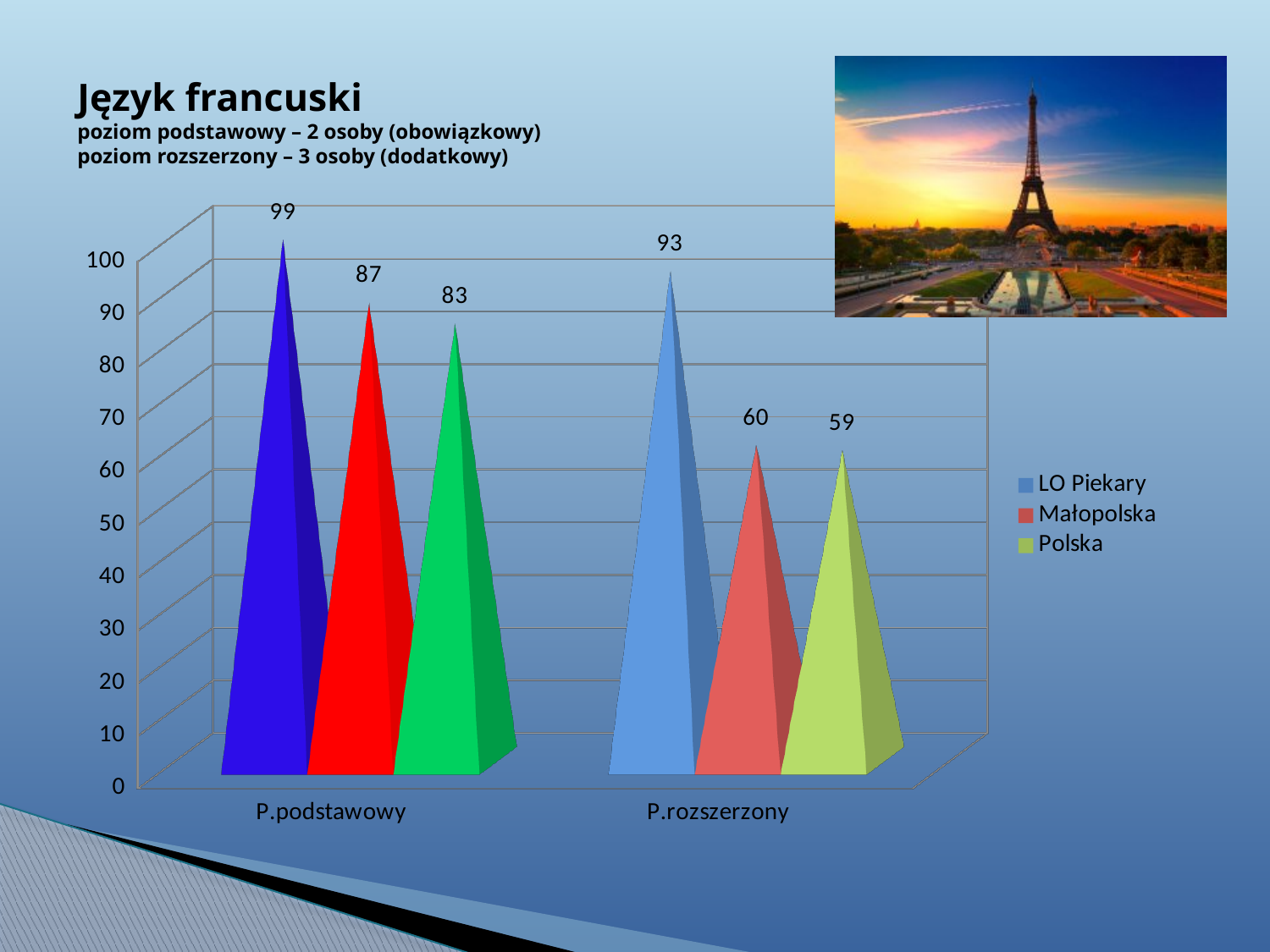
How many series does the legend list? 3 Which is larger: the Małopolska value at P.podstawowy or the Małopolska value at P.rozszerzony? P.podstawowy Which series has the lowest value at P.podstawowy? Polska What is the value for Polska at P.podstawowy? 83 What is the difference between the LO Piekary and Małopolska values at P.podstawowy? 12 What is the value for LO Piekary at P.podstawowy? 99 What is the value for Małopolska at P.rozszerzony? 60 Which series has the highest value at P.rozszerzony? LO Piekary What is the value for LO Piekary at P.rozszerzony? 93 What kind of chart is shown on the slide? bar chart What is the difference between the LO Piekary and Polska values at P.rozszerzony? 34 How many categories are shown on the x axis? 2